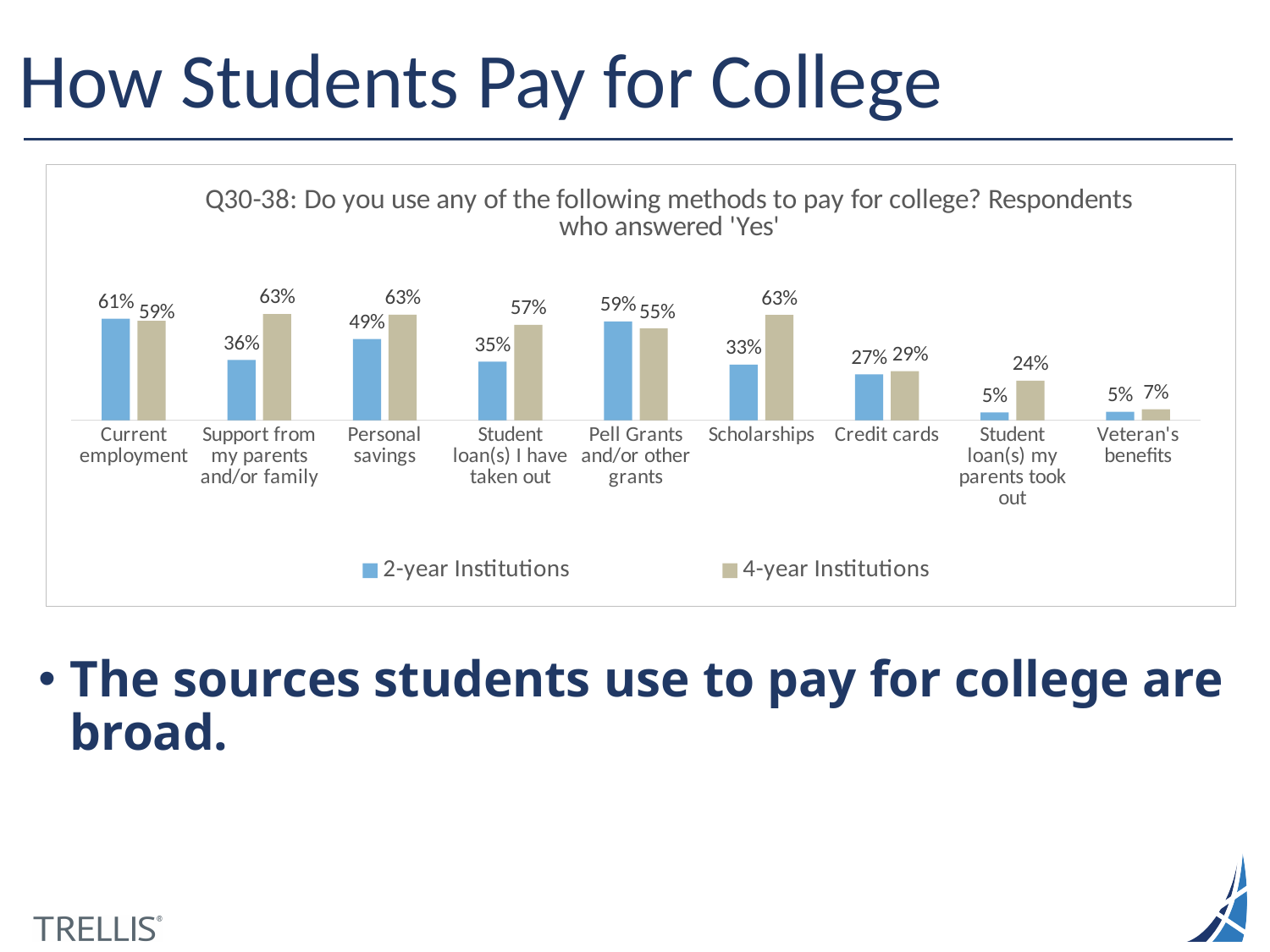
What is the difference between the 4-year and 2-year institution values for support from my parents and/or family? 27 percentage points What is the difference between the 4-year and 2-year institution values for student loan(s) I have taken out? 22 percentage points For Pell Grants and/or other grants, which is larger: the 2-year institutions value or the 4-year institutions value? 2-year Institutions How many series does the chart legend list? 2 What percentage of respondents from 2-year institutions use current employment to pay for college? 61% How many payment methods are shown on the x axis of the chart? 9 What percentage of respondents from 4-year institutions use scholarships to pay for college? 63% Which payment method has the lowest value for 4-year institutions? Veteran's benefits For personal savings, which is larger: the 2-year institutions value or the 4-year institutions value? 4-year Institutions What is the value for 4-year institutions for student loan(s) my parents took out? 24% Which payment method has the highest value for 2-year institutions? Current employment What type of chart is shown on the slide? Bar chart